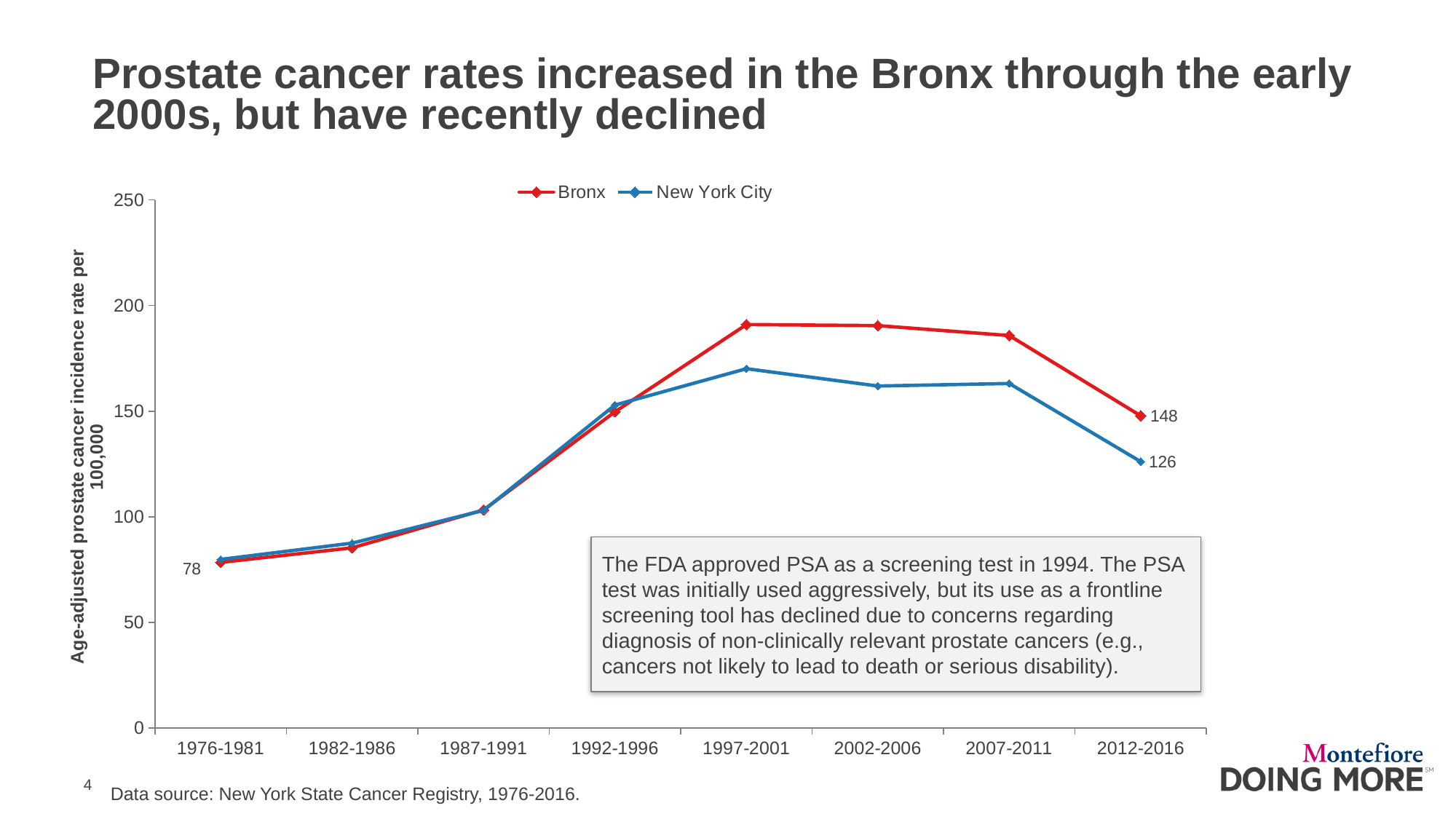
What is the Bronx prostate cancer incidence rate for 2012-2016? 148 In which period is the New York City rate highest? 1997-2001 Is the Bronx value for 1987-1991 greater or less than 150? less In 2012-2016, which has the higher rate, Bronx or New York City? Bronx What kind of chart is shown on the slide? line chart Is the Bronx value for 1997-2001 greater or less than 150? greater Does the Bronx rate rise or fall from 1976-1981 to 1997-2001? rise How many series does the legend list? 2 What is the New York City prostate cancer incidence rate for 2012-2016? 126 In which period is the Bronx rate lowest? 1976-1981 What is the difference between the Bronx and New York City rates in 2012-2016? 22 How many time periods are shown on the x axis? 8